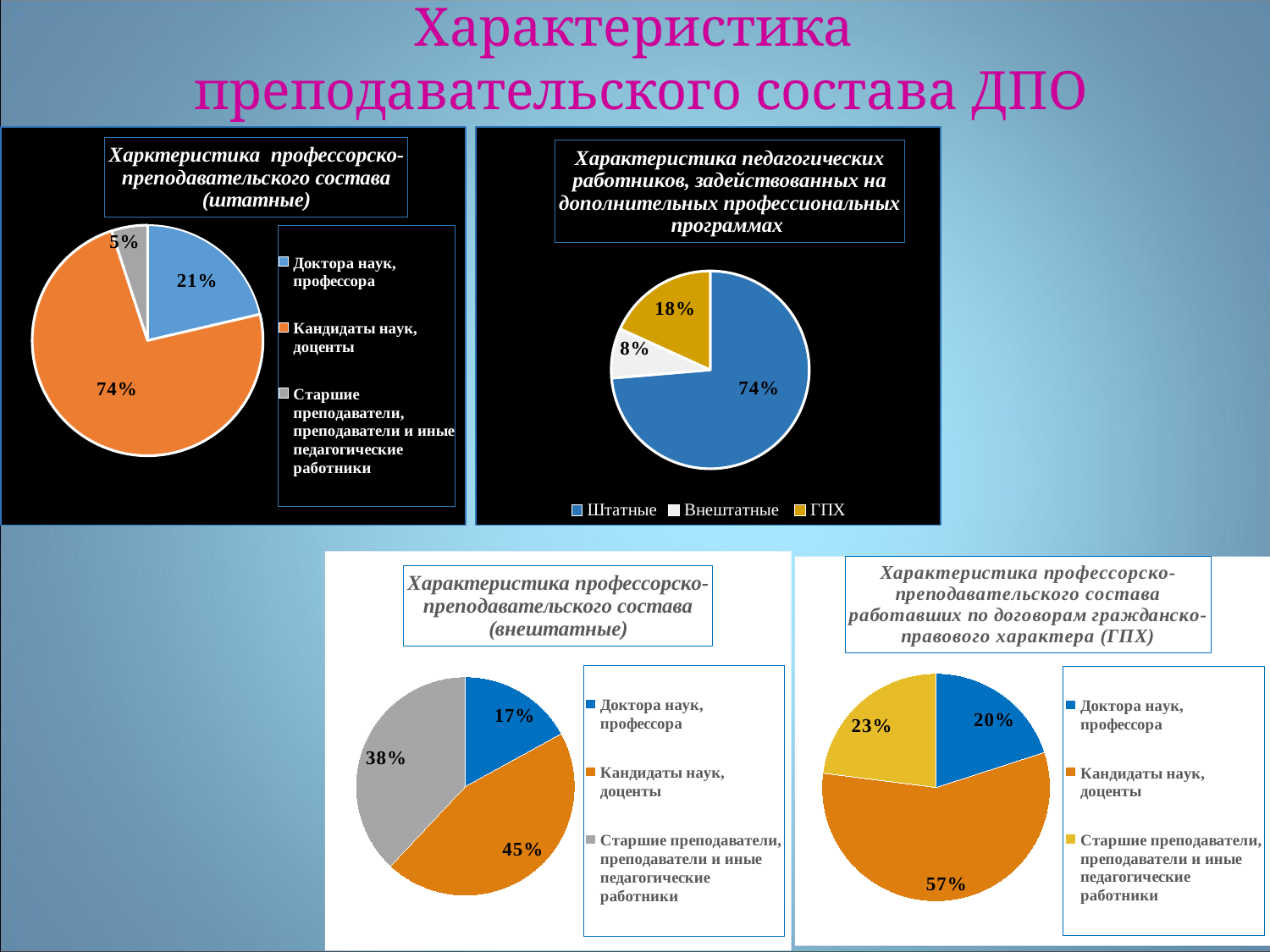
In the bottom-right chart (ГПХ), what share do Доктора наук, профессора have? 20% In the bottom-left chart (внештатные), which is larger: Доктора наук, профессора or Старшие преподаватели, преподаватели и иные педагогические работники? Старшие преподаватели, преподаватели и иные педагогические работники In the top-left chart (штатные), which category has the smallest share? Старшие преподаватели, преподаватели и иные педагогические работники What type of chart is used for all four charts on the slide? Pie chart In the bottom-left chart (внештатные), which category has the largest share? Кандидаты наук, доценты In the top-right chart, how many categories does the legend list? 3 In the top-left chart (штатные), what is the difference between the shares of Кандидаты наук, доценты and Доктора наук, профессора? 53% In the bottom-left chart (внештатные), what share do Старшие преподаватели, преподаватели и иные педагогические работники have? 38% In the top-left chart (штатные), what share do Кандидаты наук, доценты have? 74% In the top-right chart, which category has the smallest share? Внештатные In the top-right chart (педагогических работников на дополнительных профессиональных программах), what share is Штатные? 74% In the bottom-right chart (ГПХ), what is the difference between the shares of Кандидаты наук, доценты and Старшие преподаватели, преподаватели и иные педагогические работники? 34%